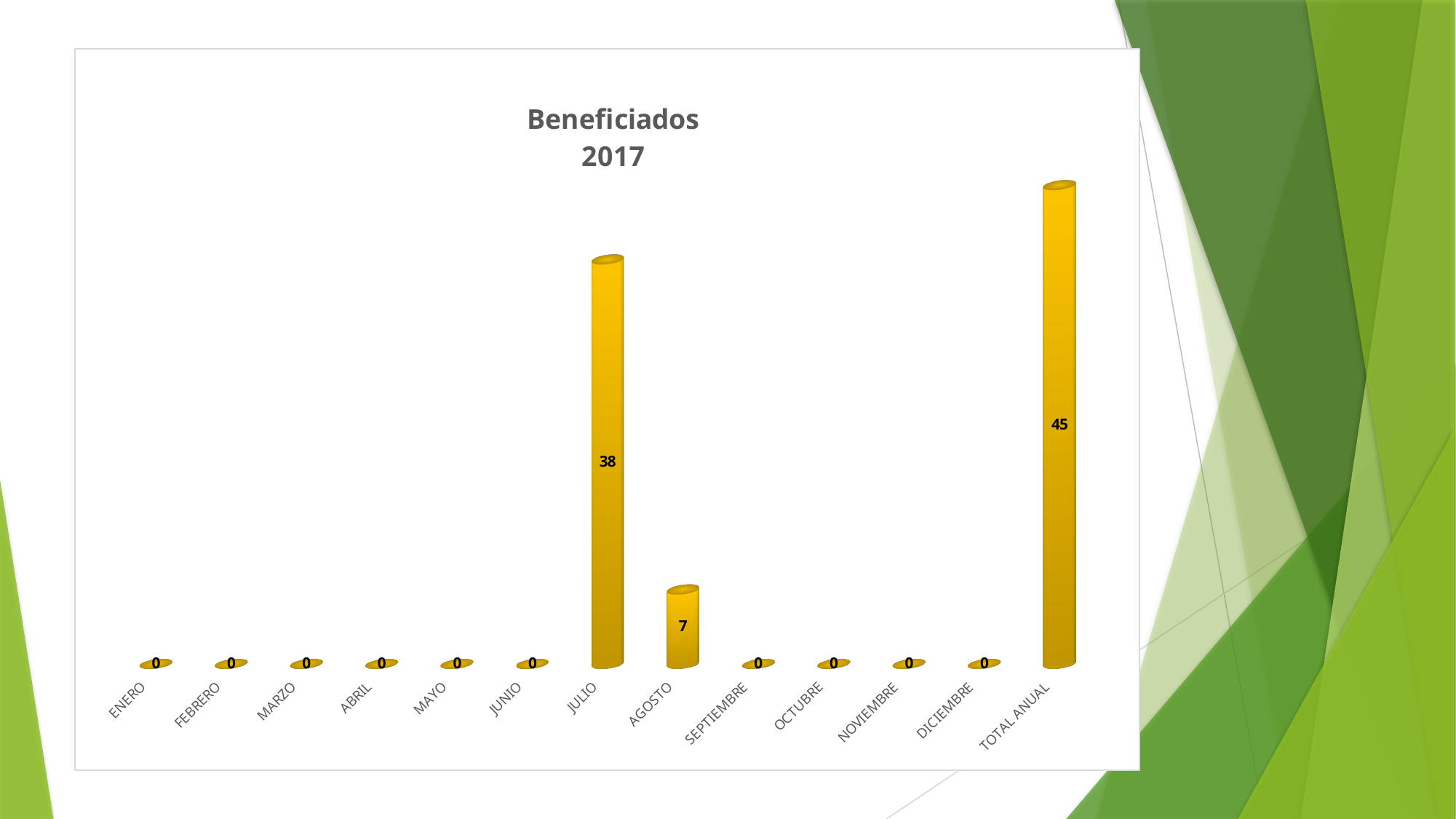
What is the value for ENERO? 0 What is the title of the chart? Beneficiados 2017 Which is larger, the value for JULIO or the value for AGOSTO? JULIO How many months have a value of 0? 10 What is the value for AGOSTO? 7 Which category has the highest value? TOTAL ANUAL What kind of chart is this? bar chart What is the value for JULIO? 38 Which month has the highest value? JULIO How many categories are shown on the x axis? 13 What is the value for TOTAL ANUAL? 45 What is the difference between the values for JULIO and AGOSTO? 31